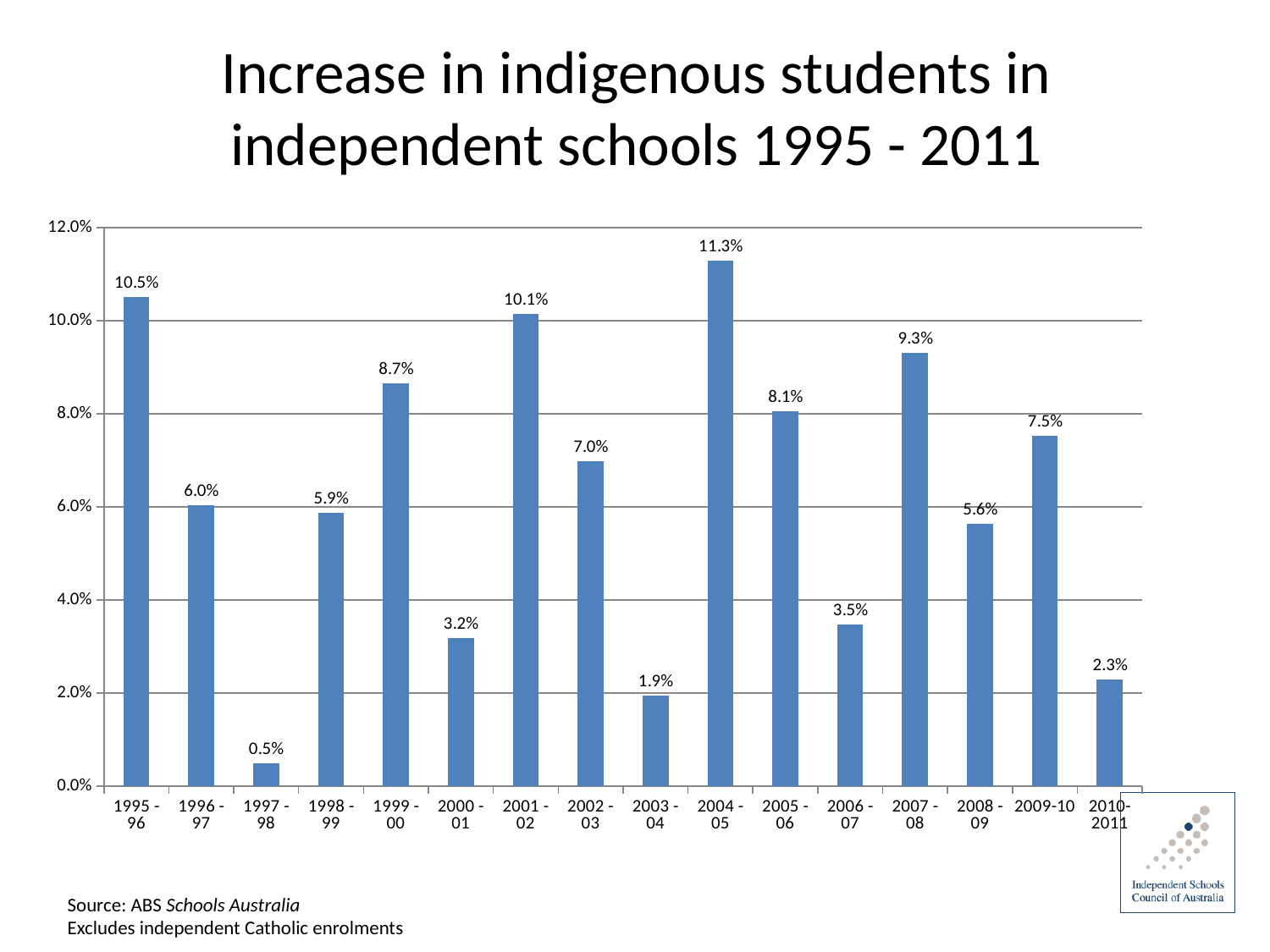
Is the value for 2005 - 06 greater or less than 8.0%? greater What is the difference between the values for 1995 - 96 and 1996 - 97? 4.5% How many periods are shown on the x axis? 16 Which period has the highest increase? 2004 - 05 What is the value for 1997 - 98? 0.5% What is the value for 2010-2011? 2.3% What kind of chart is shown on the slide? bar chart Which is larger, the value for 2001 - 02 or the value for 2007 - 08? 2001 - 02 What is the title of the chart? Increase in indigenous students in independent schools 1995 - 2011 Do the values rise or fall from 2007 - 08 to 2008 - 09? fall What is the value for 2004 - 05? 11.3% Which period has the lowest increase? 1997 - 98